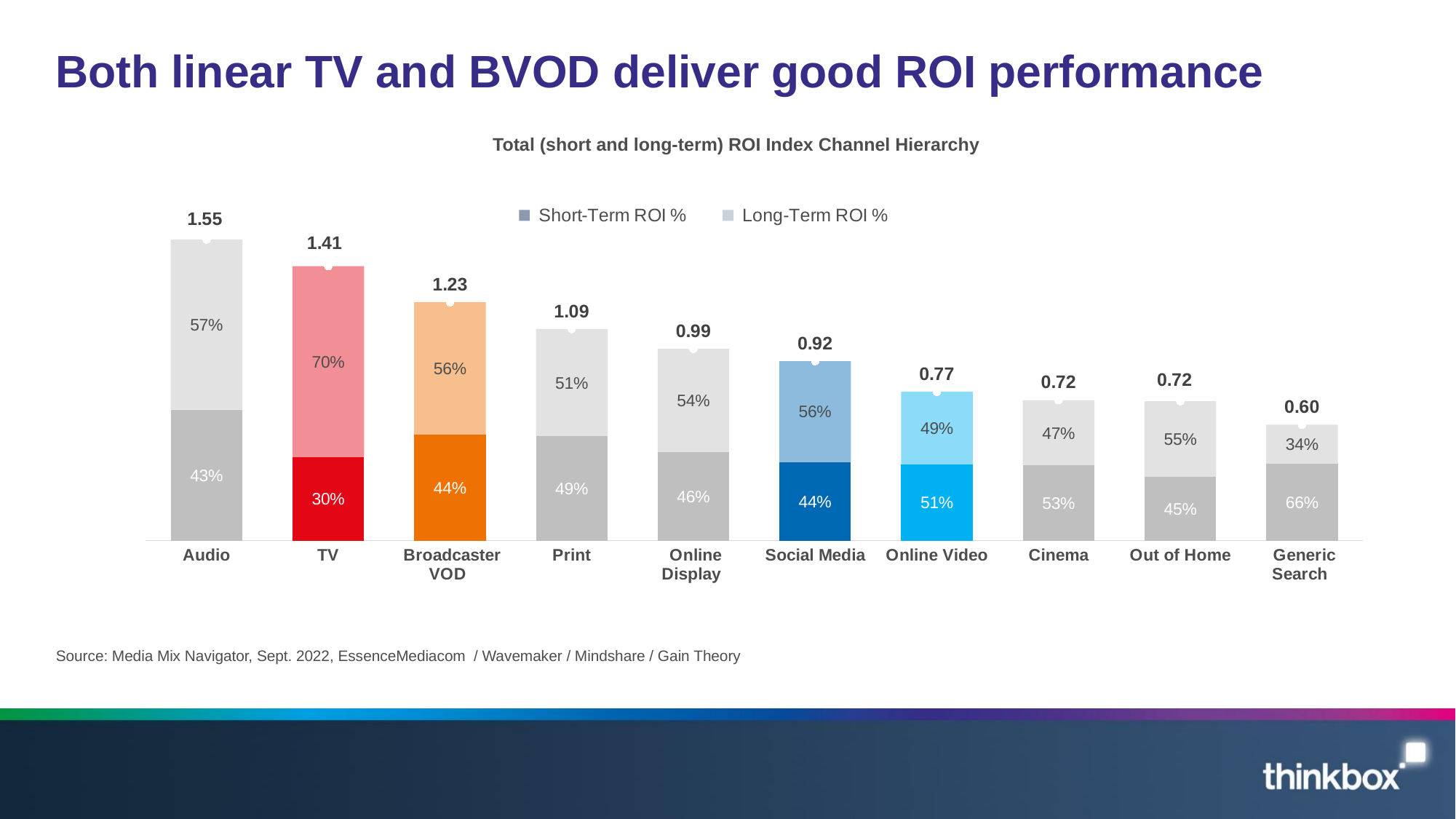
Do the total ROI index values rise or fall from left to right along the x axis? Fall Which channel has the highest total ROI index? Audio What is the Long-Term ROI % for Broadcaster VOD? 56% Which is larger, the Short-Term ROI % for Social Media or for Online Video? Online Video What is the title of the chart? Total (short and long-term) ROI Index Channel Hierarchy How many series does the legend list? 2 What is the total ROI index shown above the bar for Audio? 1.55 What is the difference between the total ROI index for TV and for Print? 0.32 Which channel has the lowest total ROI index? Generic Search What kind of chart is shown on the slide? Stacked bar chart What is the Short-Term ROI % for TV? 30% How many channels are shown on the x axis? 10